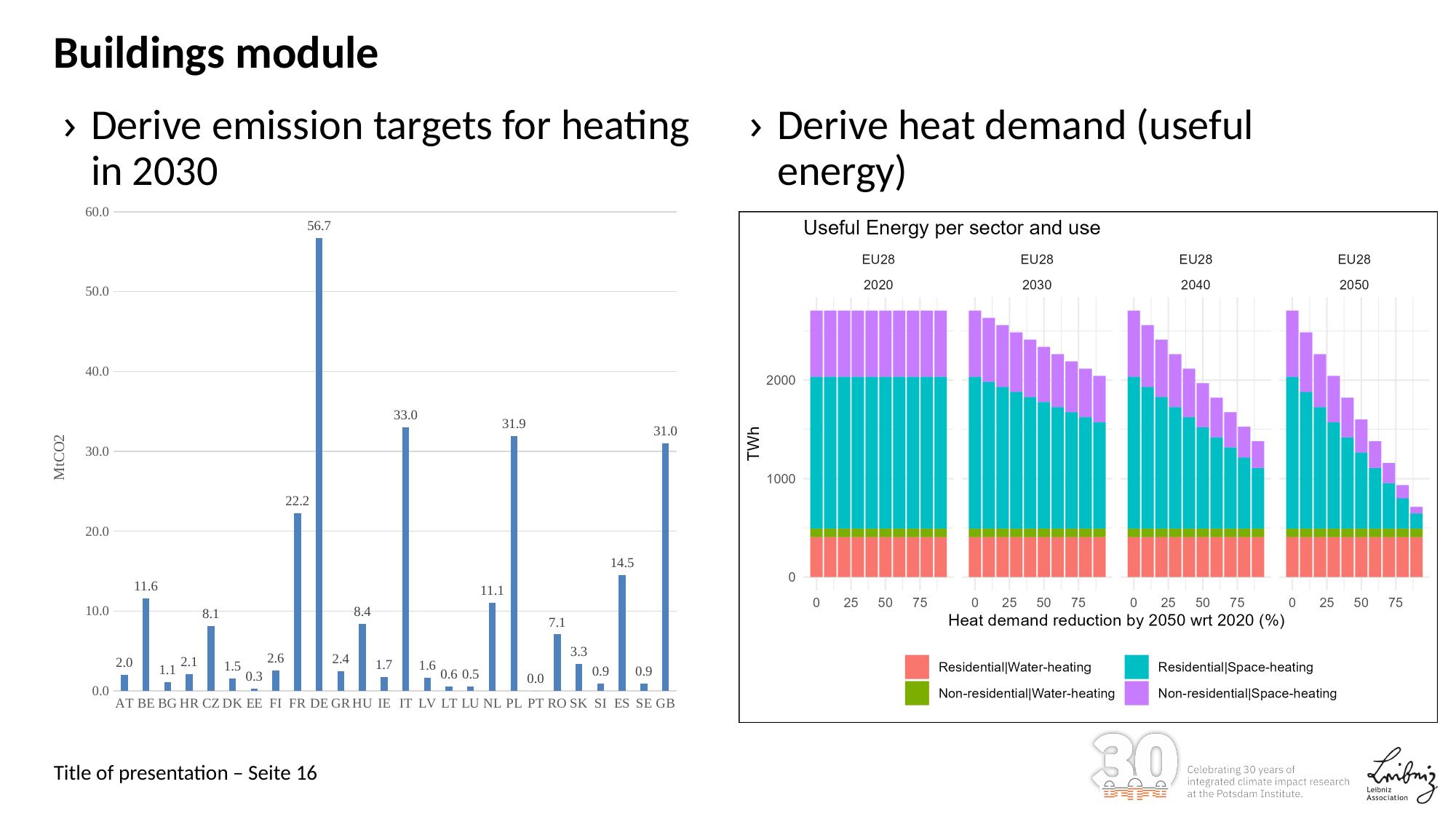
In the left chart, what is the value for DE? 56.7 In the left chart, what is the difference between the values for PL and GB? 0.9 In the left chart, which country has the highest value? DE In the chart titled 'Useful Energy per sector and use', is the total of the bar at 0% reduction in the 2020 panel greater or less than 2000 TWh? greater What unit is shown on the y axis of the left chart? MtCO2 In the left chart, what is the value for IT? 33.0 In the chart titled 'Useful Energy per sector and use', in the 2050 panel, do the total bar heights rise or fall as heat demand reduction increases? Fall In the left chart, which is larger, the value for FR or the value for ES? FR How many countries are shown on the x axis of the left chart? 26 How many series does the legend of the chart titled 'Useful Energy per sector and use' list? 4 In the left chart, which country has the lowest value? PT What kind of chart is 'Useful Energy per sector and use'? Stacked bar chart